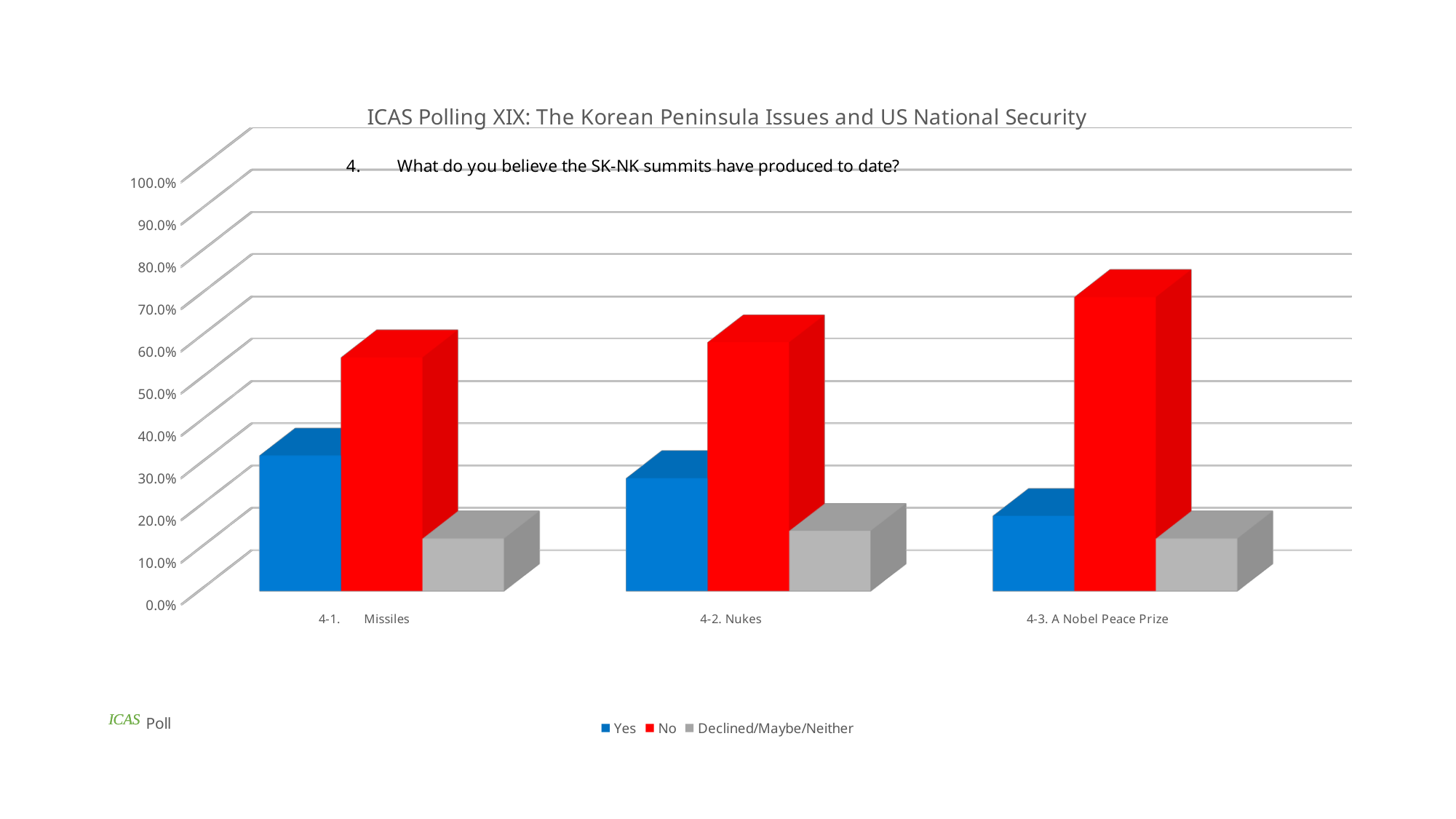
What kind of chart is shown on the slide? bar chart Is the 'Yes' value for 4-2. Nukes greater or less than 40.0%? less In which category is the 'No' bar the highest? 4-3. A Nobel Peace Prize What colour represents the 'No' series in the chart? red Do the 'Yes' values rise or fall moving from 4-1. Missiles to 4-3. A Nobel Peace Prize? fall Is the 'No' value for 4-3. A Nobel Peace Prize greater or less than 60.0%? greater Is the 'Yes' value for 4-1. Missiles larger or smaller than the 'Yes' value for 4-2. Nukes? larger How many series does the chart's legend list? 3 How many categories are shown on the x axis of the chart? 3 Which series has the tallest bar in every category? No In which category is the 'Yes' bar the lowest? 4-3. A Nobel Peace Prize Is the 'Declined/Maybe/Neither' value for 4-1. Missiles greater or less than 20.0%? less